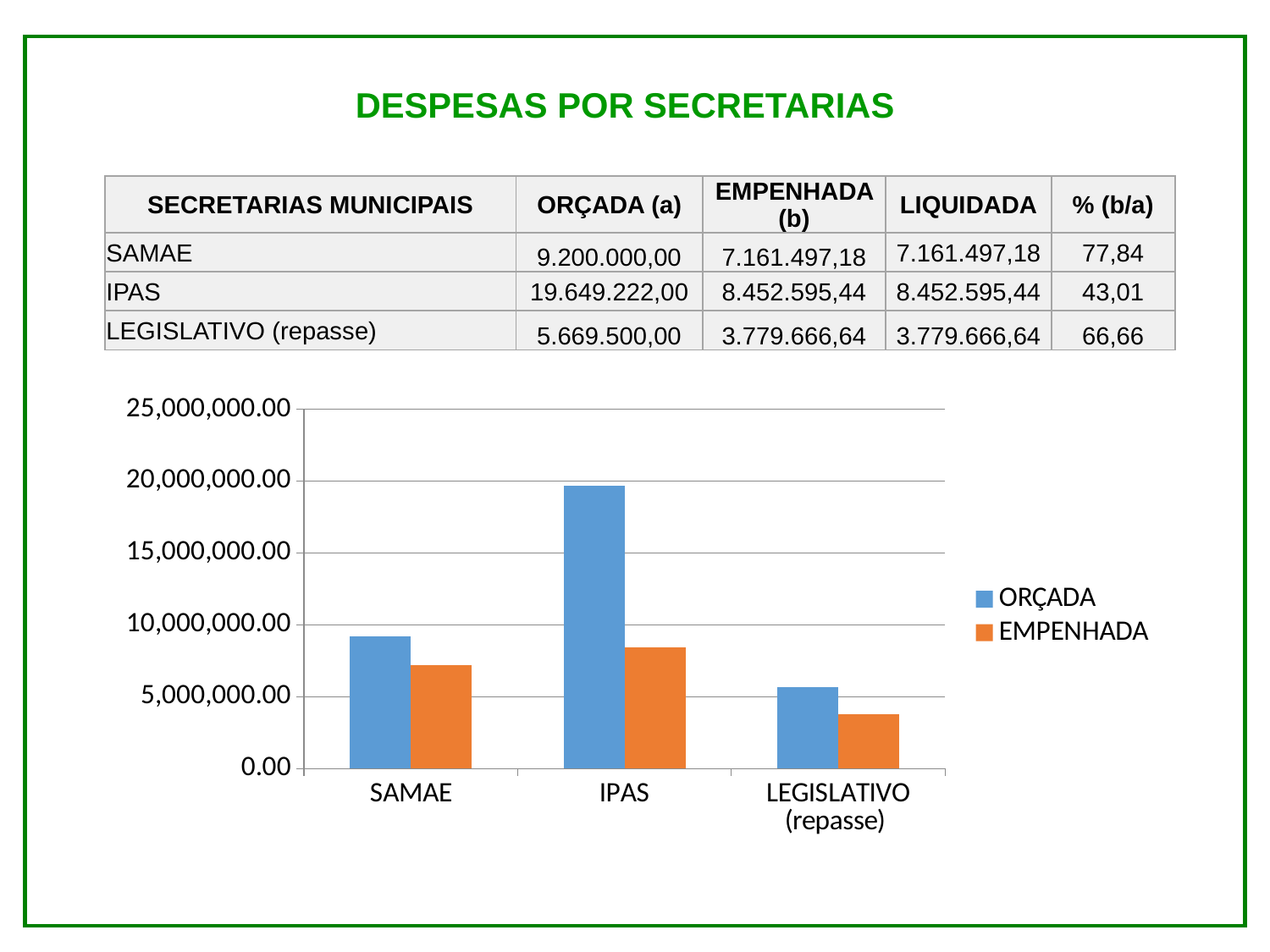
Which category has the highest ORÇADA bar in the chart? IPAS Which category has the lowest EMPENHADA bar in the chart? LEGISLATIVO (repasse) Is the ORÇADA value for SAMAE greater or less than 10,000,000.00? less Is the ORÇADA value for IPAS greater or less than 15,000,000.00? greater Is the EMPENHADA value for LEGISLATIVO (repasse) greater or less than 5,000,000.00? less Which is larger, the ORÇADA bar for SAMAE or the ORÇADA bar for LEGISLATIVO (repasse)? SAMAE According to the table on the slide, what is the EMPENHADA value for SAMAE? 7.161.497,18 How many categories are shown on the x axis of the chart? 3 What kind of chart is shown on the slide? bar chart Which colour represents the EMPENHADA series in the chart? orange How many series does the chart legend list? 2 According to the table on the slide, what is the ORÇADA value for IPAS? 19.649.222,00